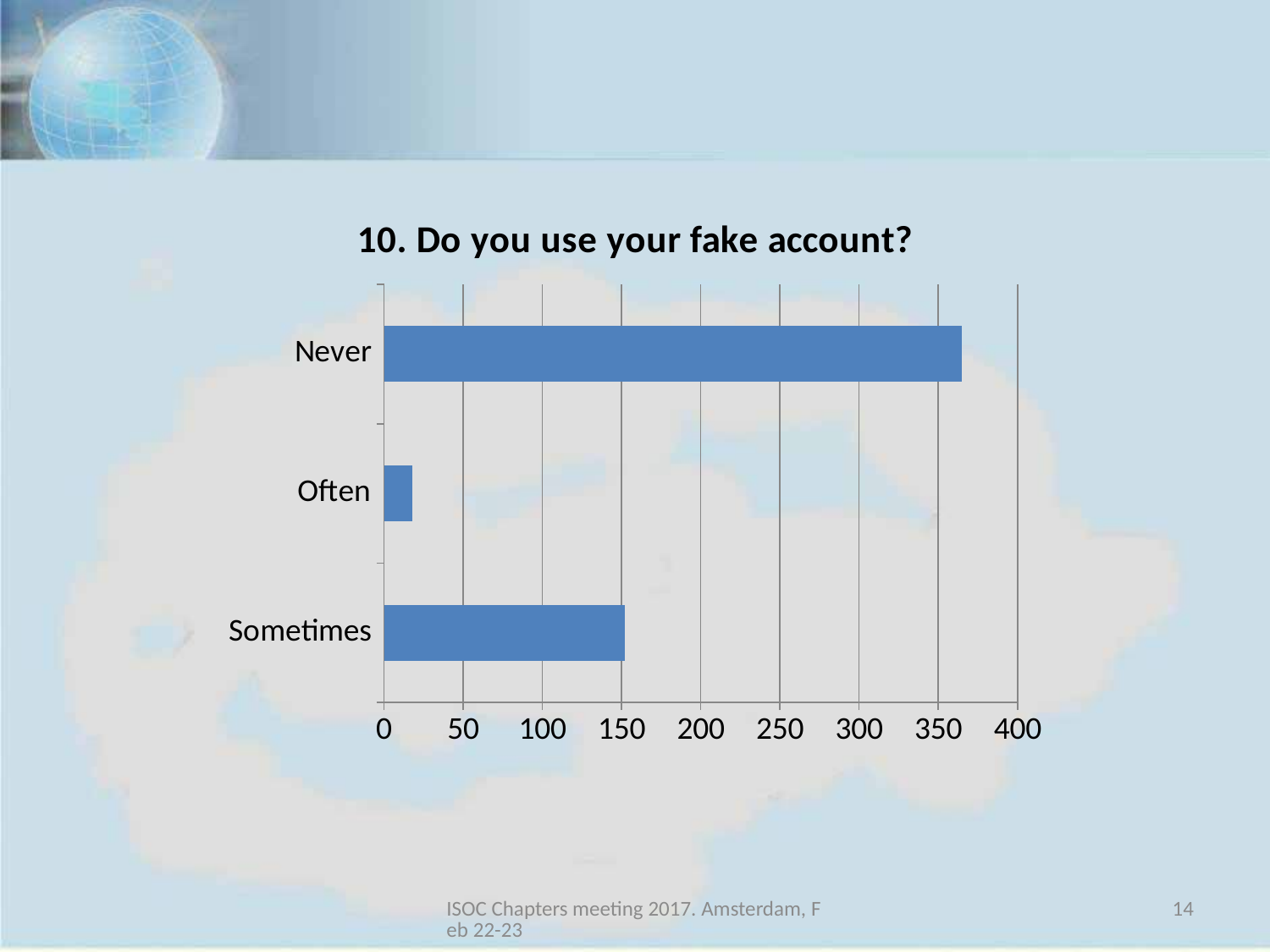
Is the value for Sometimes greater or less than 100? greater Which category has the highest value? Never Is the value for Sometimes greater or less than 200? less Is the value for Never greater or less than 350? greater What is the title of the chart? 10. Do you use your fake account? How many categories does the chart show? 3 Which is larger, the value for Never or the value for Sometimes? Never What is the highest value shown on the x axis? 400 What kind of chart is shown on the slide? bar chart Which is larger, the value for Sometimes or the value for Often? Sometimes Which category has the lowest value? Often